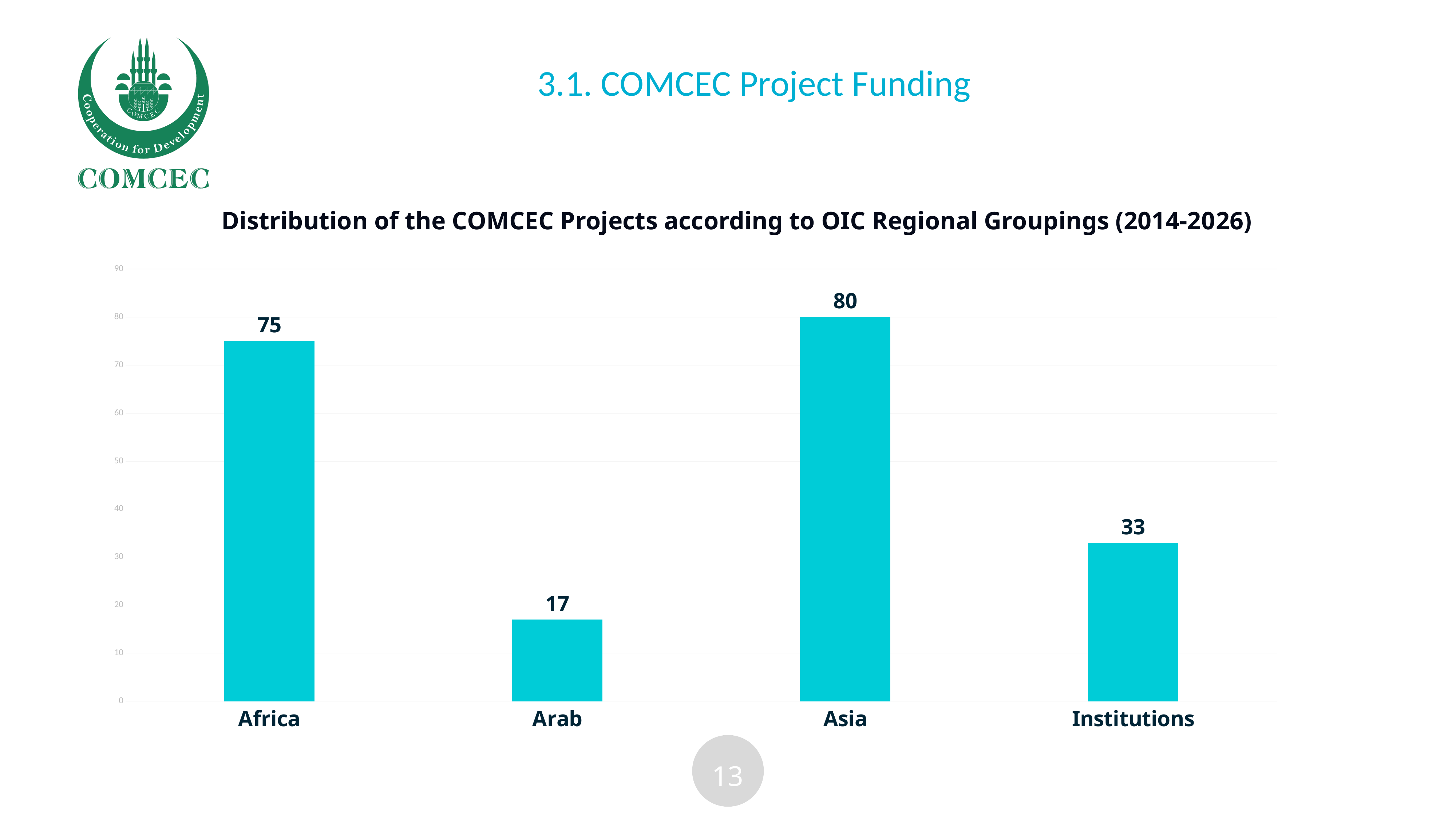
What is the difference between the values for Institutions and Arab? 16 What kind of chart is shown on the slide? Bar chart How many categories are shown on the x axis? 4 What is the difference between the values for Asia and Africa? 5 What is the value for Africa? 75 Which category has the highest value? Asia Which category has the lowest value? Arab Which is larger, the value for Africa or the value for Institutions? Africa What is the value for Arab? 17 What is the title of the chart? Distribution of the COMCEC Projects according to OIC Regional Groupings (2014-2026) What is the value for Asia? 80 What is the value for Institutions? 33